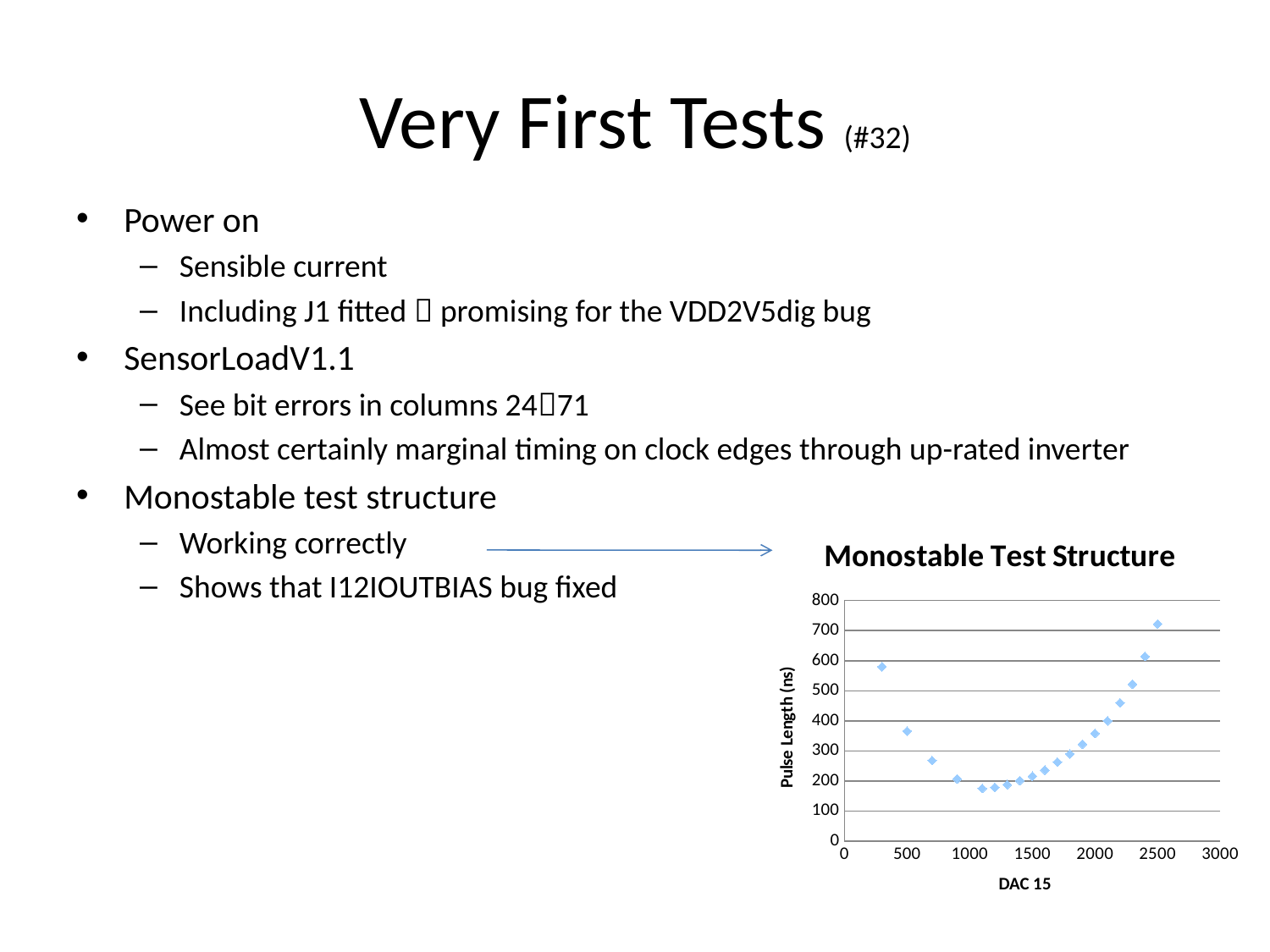
What kind of chart is the Monostable Test Structure chart? scatter plot On the Monostable Test Structure chart, is the pulse length at DAC 15 = 700 greater or less than 400? less On the Monostable Test Structure chart, is the pulse length at DAC 15 = 2000 greater or less than 300? greater On the Monostable Test Structure chart, is the pulse length at DAC 15 = 2500 greater or less than 600? greater What is the title of the chart on the slide? Monostable Test Structure On the Monostable Test Structure chart, which has the larger pulse length: the point at DAC 15 = 700 or the point at DAC 15 = 2100? DAC 15 = 2100 What is the label of the y axis on the Monostable Test Structure chart? Pulse Length (ns) On the Monostable Test Structure chart, do the pulse length values rise or fall as DAC 15 increases from 1500 to 2500? rise On the Monostable Test Structure chart, which has the larger pulse length: the point at DAC 15 = 300 or the point at DAC 15 = 2500? DAC 15 = 2500 On the Monostable Test Structure chart, do the pulse length values rise or fall as DAC 15 increases from 300 to 1000? fall